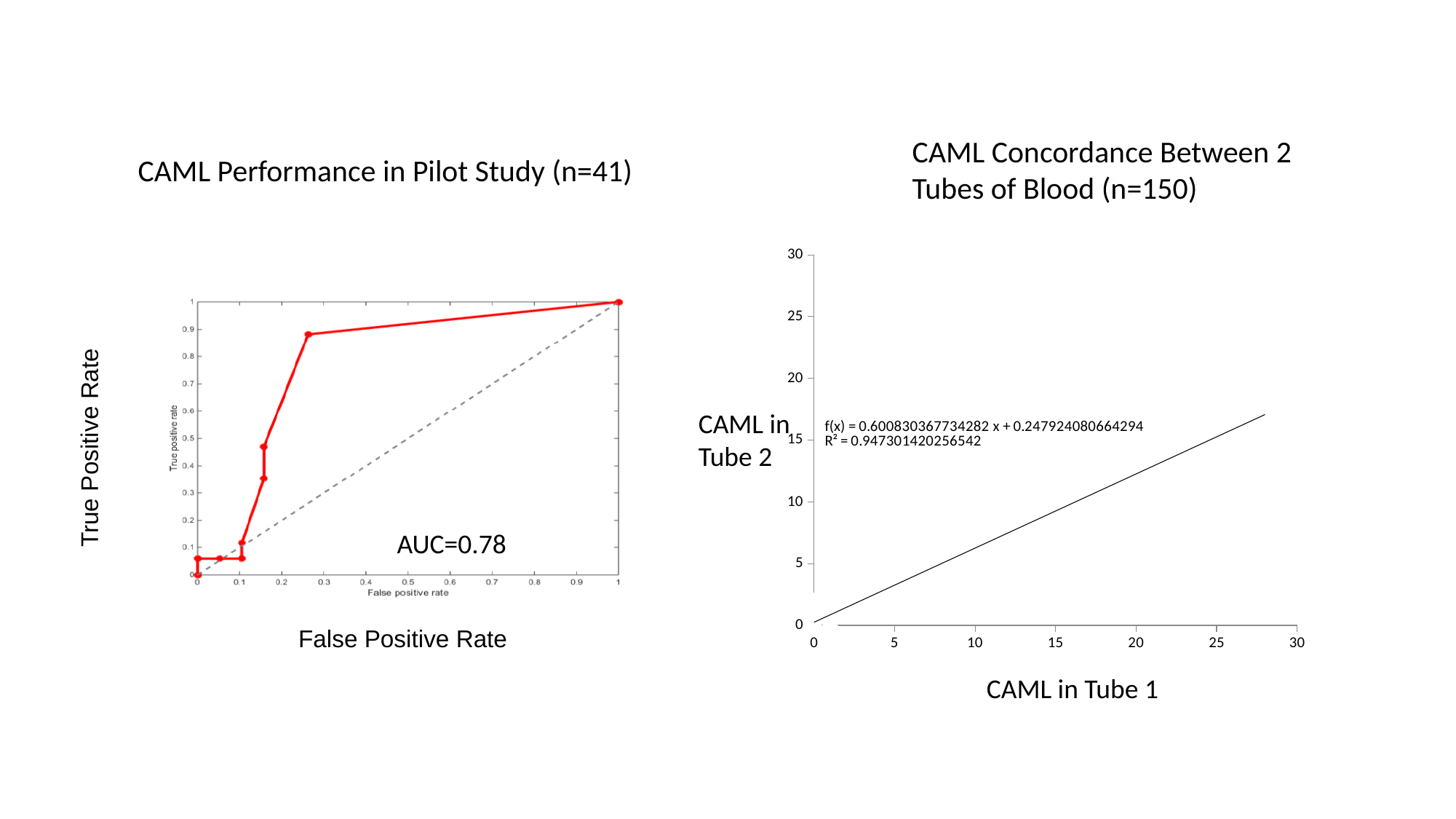
On the right chart, what R² value is printed for the trendline? R² = 0.947301420256542 On the right chart, what is the label of the x axis? CAML in Tube 1 What is the title of the left chart? CAML Performance in Pilot Study (n=41) On the right chart, what is the equation of the fitted line shown? f(x) = 0.600830367734282 x + 0.247924080664294 On the right chart, does the fitted line rise or fall as CAML in Tube 1 increases? rise What is the title of the right chart? CAML Concordance Between 2 Tubes of Blood (n=150) On the right chart, what is the maximum value shown on the x axis? 30 On the left chart, what AUC value is printed on the plot? AUC=0.78 What kind of chart is the left chart? line chart (ROC curve) On the left chart, is the true positive rate of the red curve at a false positive rate of about 0.26 greater or less than 0.8? greater On the right chart, is the fitted line's value at CAML in Tube 1 = 20 greater or less than 10? greater On the left chart, does the red curve rise or fall as the false positive rate increases? rise